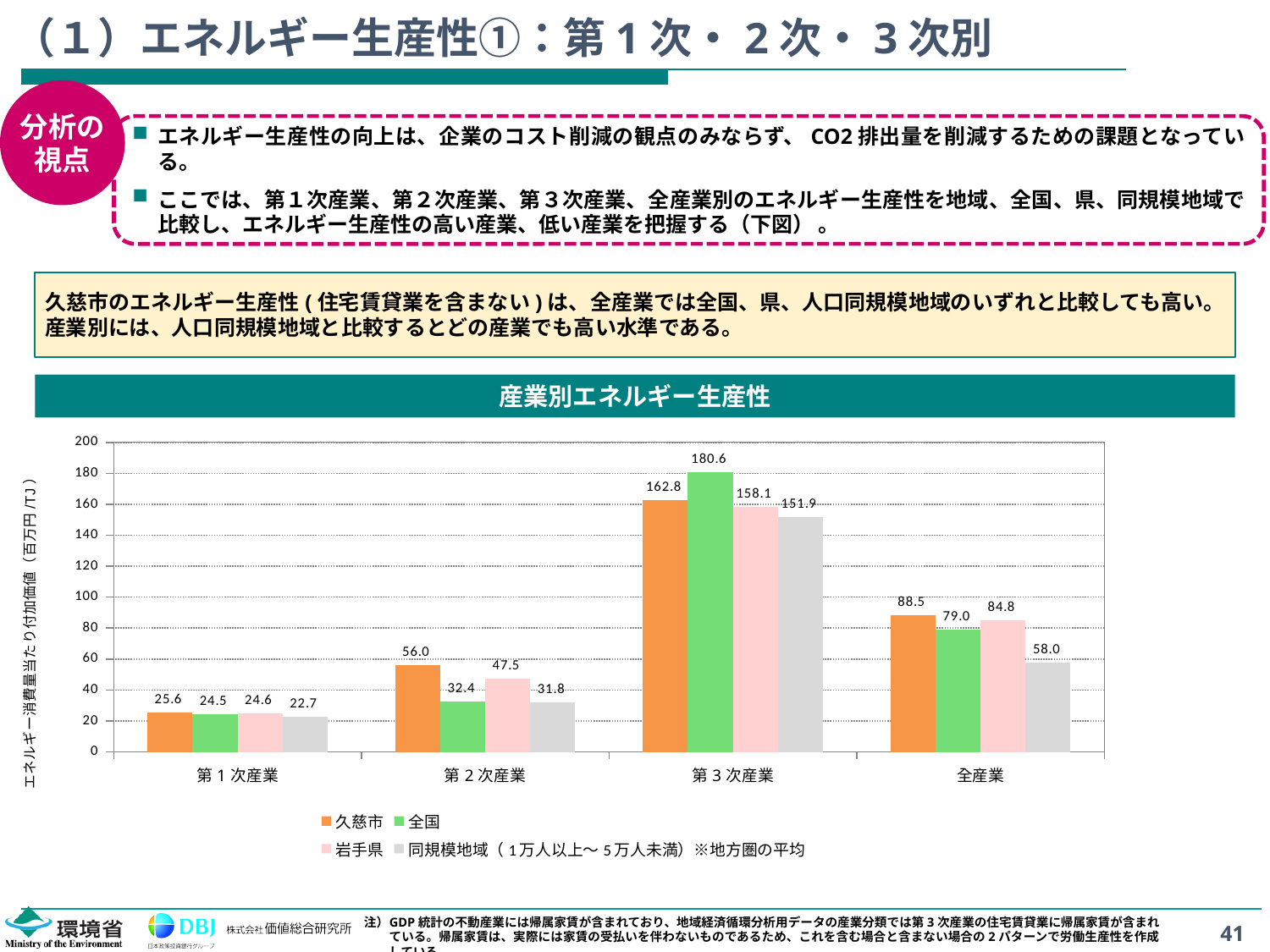
What is the difference between the 久慈市 and 全国 values in the 第2次産業 category? 23.6 What is the value for 同規模地域 in the 全産業 category? 58.0 What is the value for 久慈市 in the 第3次産業 category? 162.8 What is the value for 岩手県 in the 第2次産業 category? 47.5 Which is larger in the 全産業 category: the value for 久慈市 or the value for 岩手県? 久慈市 Which series has the lowest value in the 第2次産業 category? 同規模地域 How many series does the legend list? 4 Which series has the highest value in the 第3次産業 category? 全国 How many industry categories are shown on the x axis? 4 What kind of chart is shown on the slide? bar chart Is the value for 全国 in the 第3次産業 category greater or less than 160? greater What is the title of the chart? 産業別エネルギー生産性